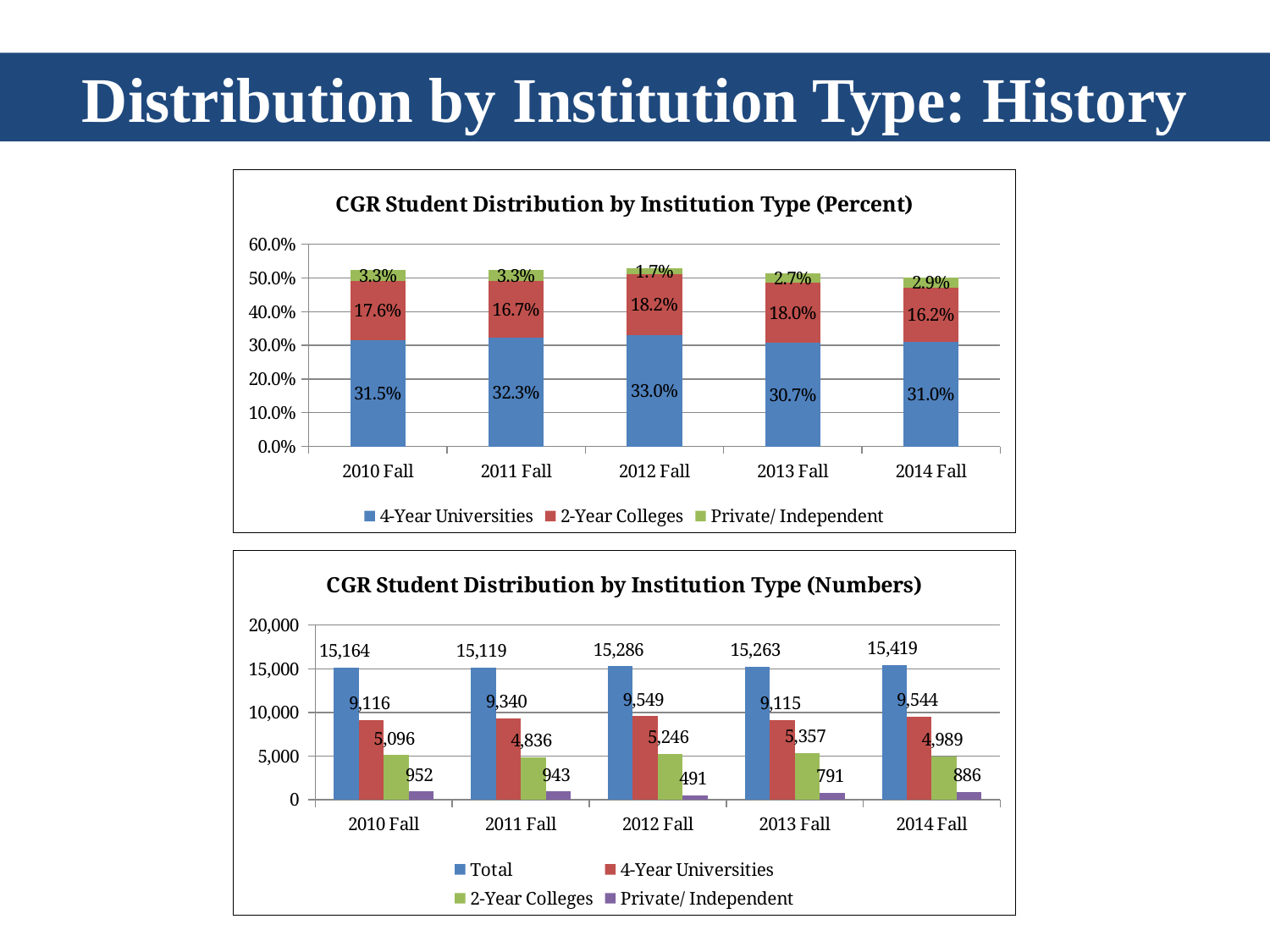
In the top chart (Percent), what is the total of the stacked bar for 2010 Fall? 52.4% In the top chart (Percent), what is the value for Private/ Independent in 2013 Fall? 2.7% In the bottom chart (Numbers), how many years are shown on the x axis? 5 In the bottom chart (Numbers), what is the difference between the 4-Year Universities values for 2012 Fall and 2013 Fall? 434 In the top chart (Percent), which year has the lowest Private/ Independent share? 2012 Fall In the top chart (CGR Student Distribution by Institution Type (Percent)), what is the value for 4-Year Universities in 2012 Fall? 33.0% In the top chart (Percent), how many series does the legend list? 3 In the bottom chart (CGR Student Distribution by Institution Type (Numbers)), what is the Total for 2014 Fall? 15,419 In the bottom chart (Numbers), which is larger: Private/ Independent in 2010 Fall or in 2014 Fall? 2010 Fall In the top chart (Percent), what kind of chart is shown? Stacked bar chart In the bottom chart (Numbers), which year has the highest value for 4-Year Universities? 2012 Fall In the bottom chart (Numbers), what is the value for 2-Year Colleges in 2013 Fall? 5,357